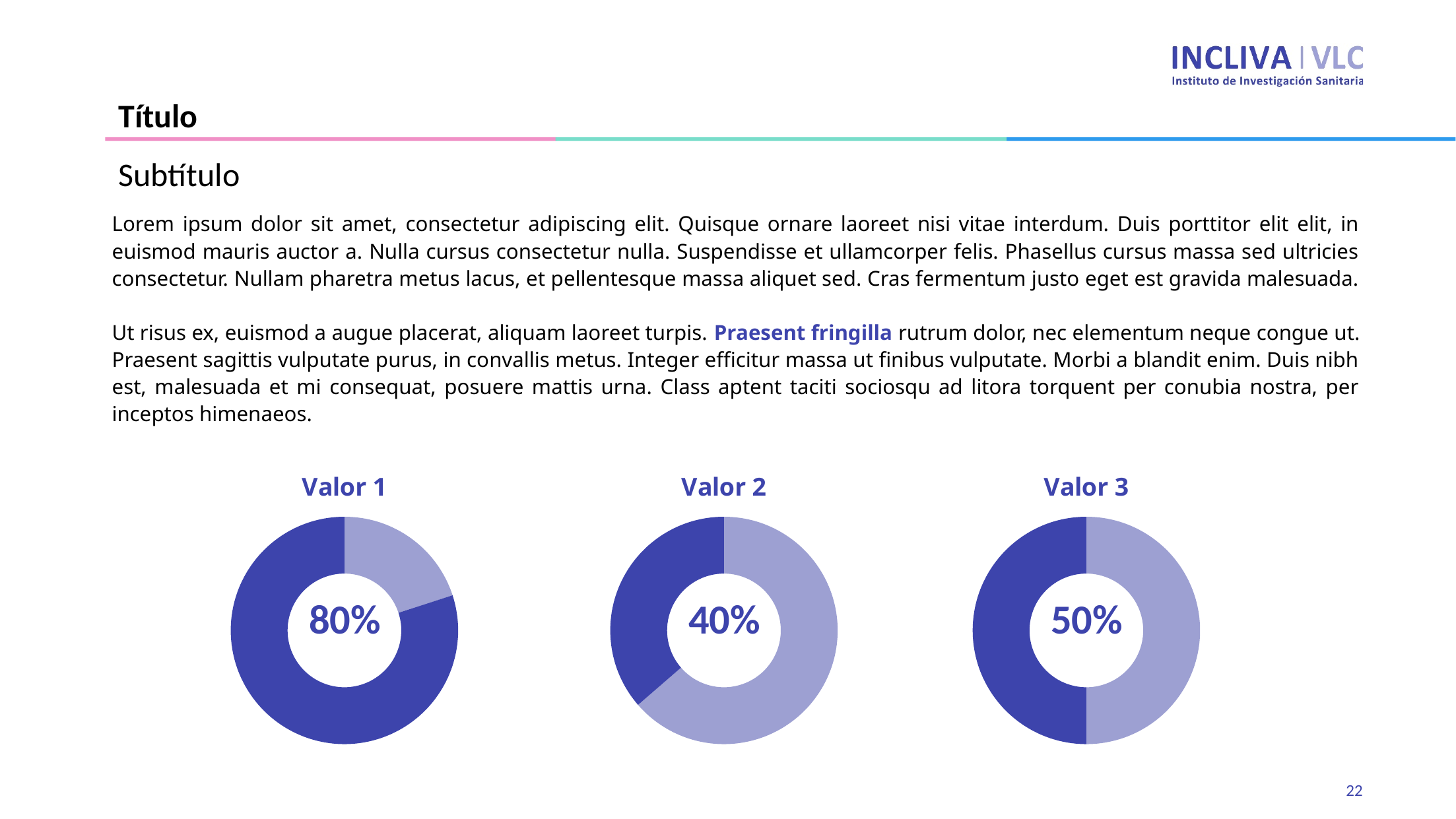
Which of the three donut charts shows the lowest percentage? Valor 2 What value is shown in the centre of the Valor 1 donut chart? 80% What is the difference between the percentage shown for Valor 3 and the percentage shown for Valor 2? 10% What is the title of the chart on the far right of the slide? Valor 3 What is the difference between the percentage shown for Valor 1 and the percentage shown for Valor 2? 40% What kind of chart is used to display Valor 1, Valor 2 and Valor 3? Donut chart Which of the three donut charts shows the highest percentage? Valor 1 What value is shown in the centre of the Valor 3 donut chart? 50% What value is shown in the centre of the Valor 2 donut chart? 40% Which shows a larger percentage, Valor 1 or Valor 3? Valor 1 Which shows a larger percentage, Valor 2 or Valor 3? Valor 3 How many donut charts are shown on the slide? 3